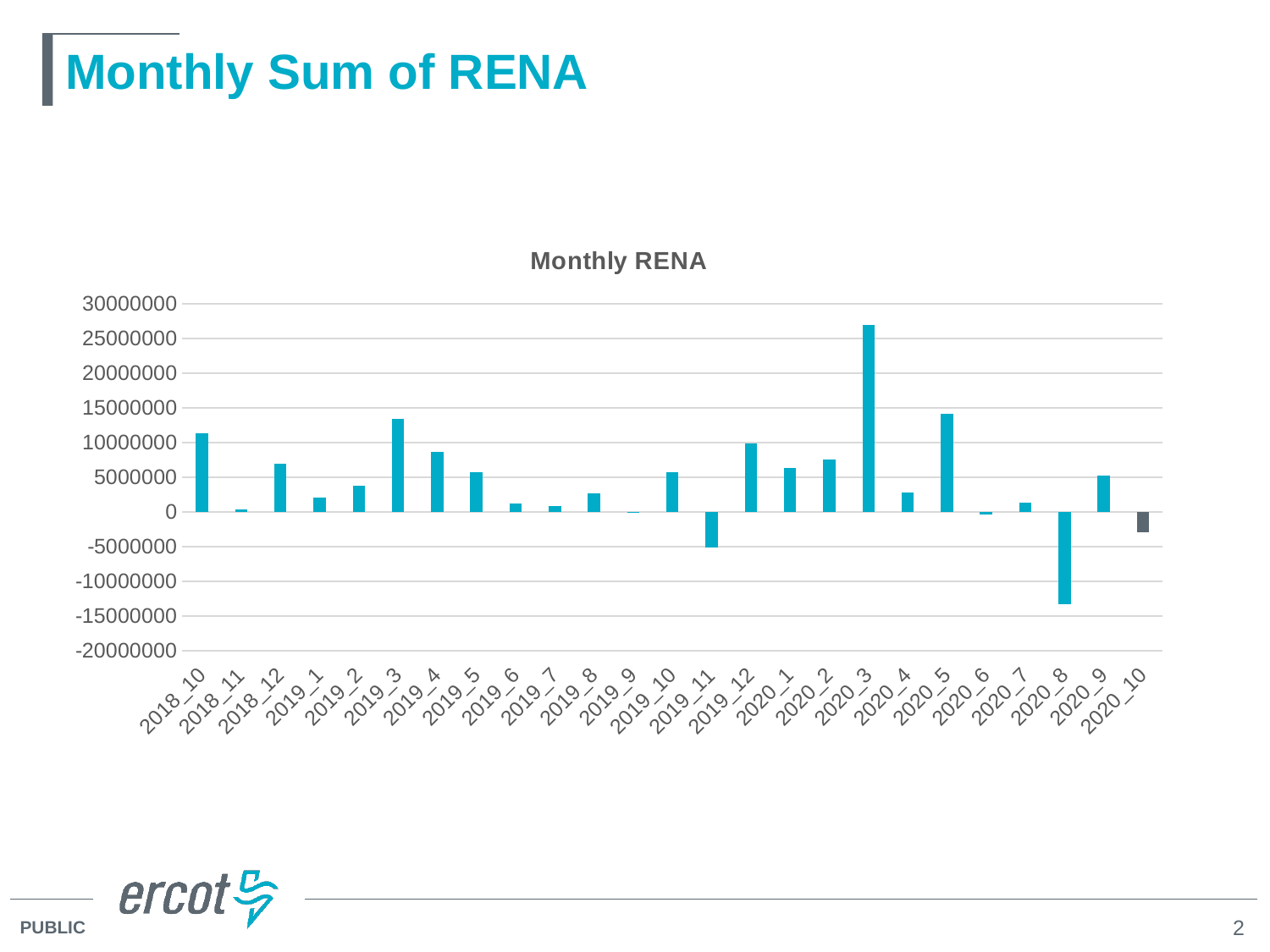
Is the value for 2020_3 greater or less than 25000000? greater Which bar is drawn in a different colour from the rest? 2020_10 Which month has the lowest Monthly RENA value? 2020_8 Which month has the highest Monthly RENA value? 2020_3 Is the value for 2019_6 greater or less than 5000000? less How many months (categories) are plotted on the x axis? 25 Which is larger, the value for 2020_3 or the value for 2019_3? 2020_3 Is the value for 2020_8 greater or less than -10000000? less What kind of chart is shown on the slide? bar chart What is the title of the chart? Monthly RENA